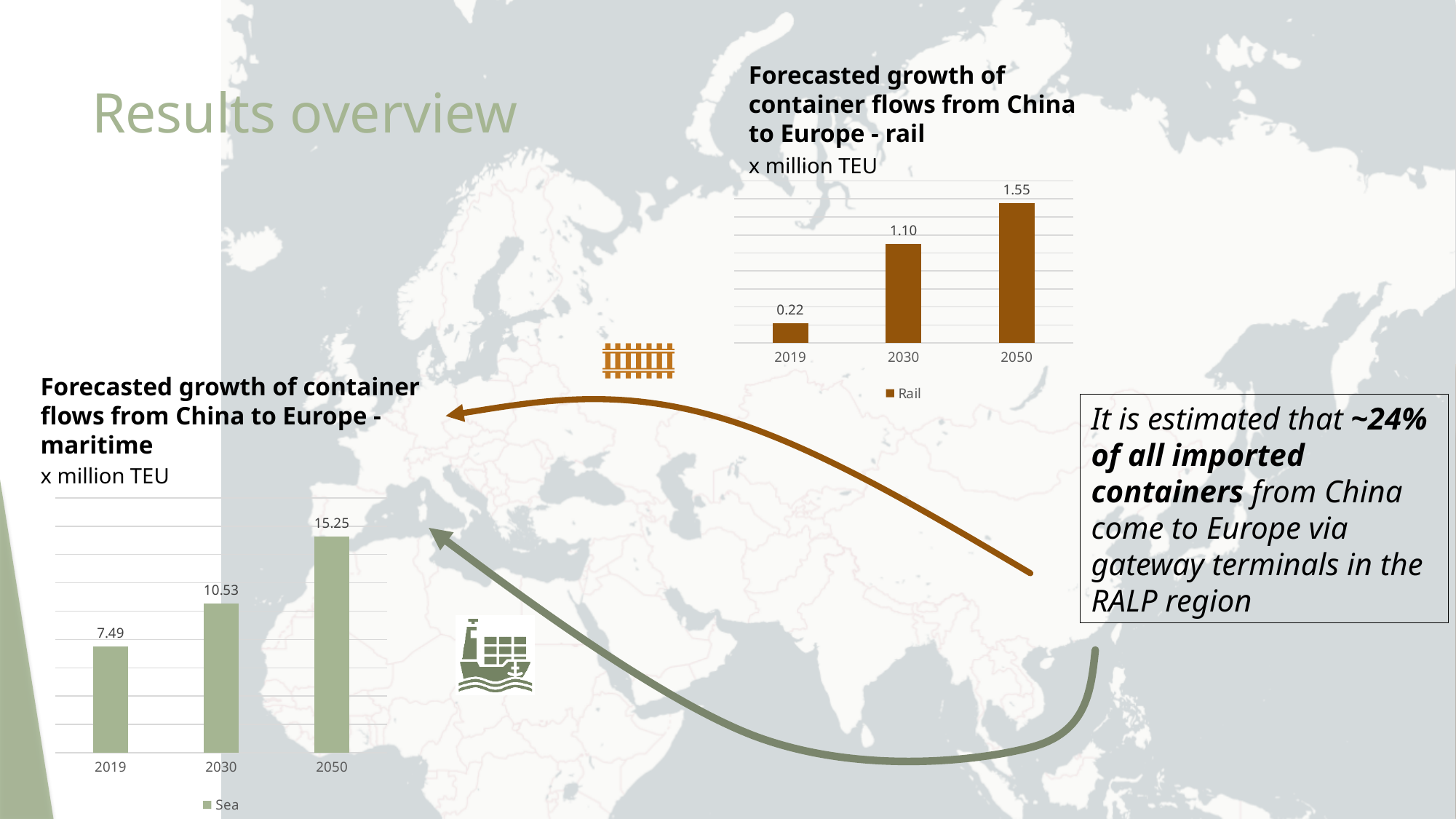
In the maritime chart, what is the value for 2019? 7.49 In the maritime chart, which year has the highest value? 2050 In the maritime chart, what is the value for 2030? 10.53 How many years are shown on the x axis of the maritime chart? 3 In the rail chart, what is the forecasted container flow for 2050? 1.55 In the rail chart, is the value for 2030 larger than the value for 2019? Yes In the rail chart, which year has the lowest value? 2019 In the rail chart, what is the difference between the 2050 and 2030 values? 0.45 What type of chart is the rail chart? Bar chart In the rail chart, what is the value for 2019? 0.22 In the maritime chart, do the values rise or fall from 2019 to 2050? Rise In the maritime chart, what is the difference between the 2050 and 2019 values? 7.76